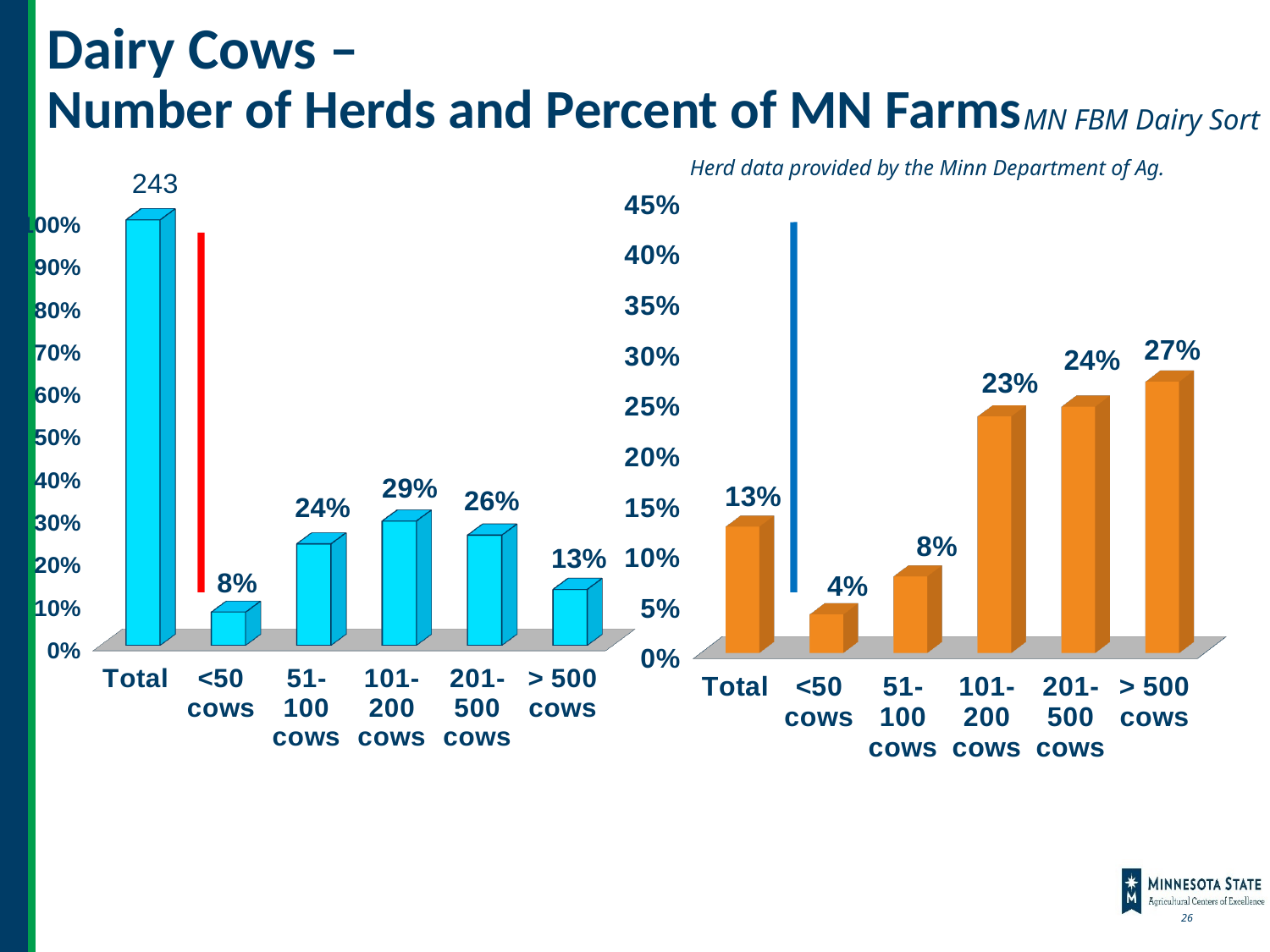
What kind of chart is the left chart? Bar chart In the left chart, what is the difference between the values for 101-200 cows and 201-500 cows? 3% In the left chart, what is the value for 101-200 cows? 29% In the right chart, which is larger, the value for 51-100 cows or the value for 101-200 cows? 101-200 cows In the right chart, what is the difference between the values for > 500 cows and <50 cows? 23% How many categories are shown on the x axis of the right chart? 6 In the right chart, which herd-size category (excluding Total) has the lowest value? <50 cows In the left chart, which herd-size category (excluding Total) has the highest value? 101-200 cows In the left chart, what is the value for <50 cows? 8% In the right chart, what is the value for > 500 cows? 27% In the right chart, what is the value for Total? 13% In the left chart, what number is printed above the Total bar? 243